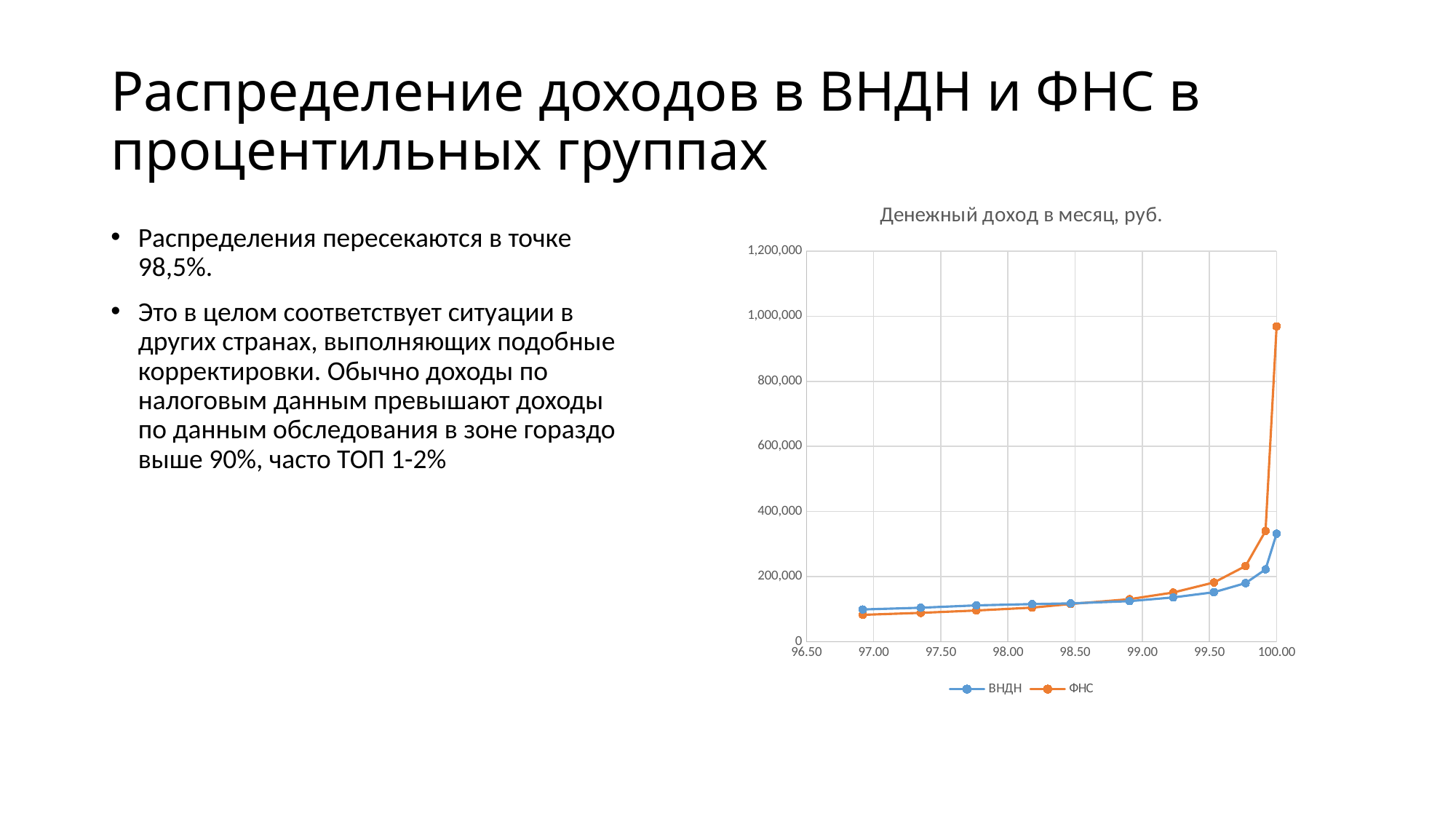
How many series does the chart legend list? 2 At the leftmost data point (near 97.00), which series has the higher value, ВНДН or ФНС? ВНДН Do the values of the ФНС series rise or fall as the x axis increases? rise Is the value of the ВНДН series at 100.00 greater or less than 400,000? less Which series reaches the highest value on the chart? ФНС What is the title of the chart? Денежный доход в месяц, руб. What kind of chart is shown on the slide? line chart Is the value of the ВНДН series at the leftmost point (near 97.00) greater or less than 200,000? less Is the value of the ВНДН series at about 99.50 greater or less than 200,000? less At 100.00 on the x axis, which series has the higher value, ВНДН or ФНС? ФНС Which two series are listed in the chart legend? ВНДН and ФНС